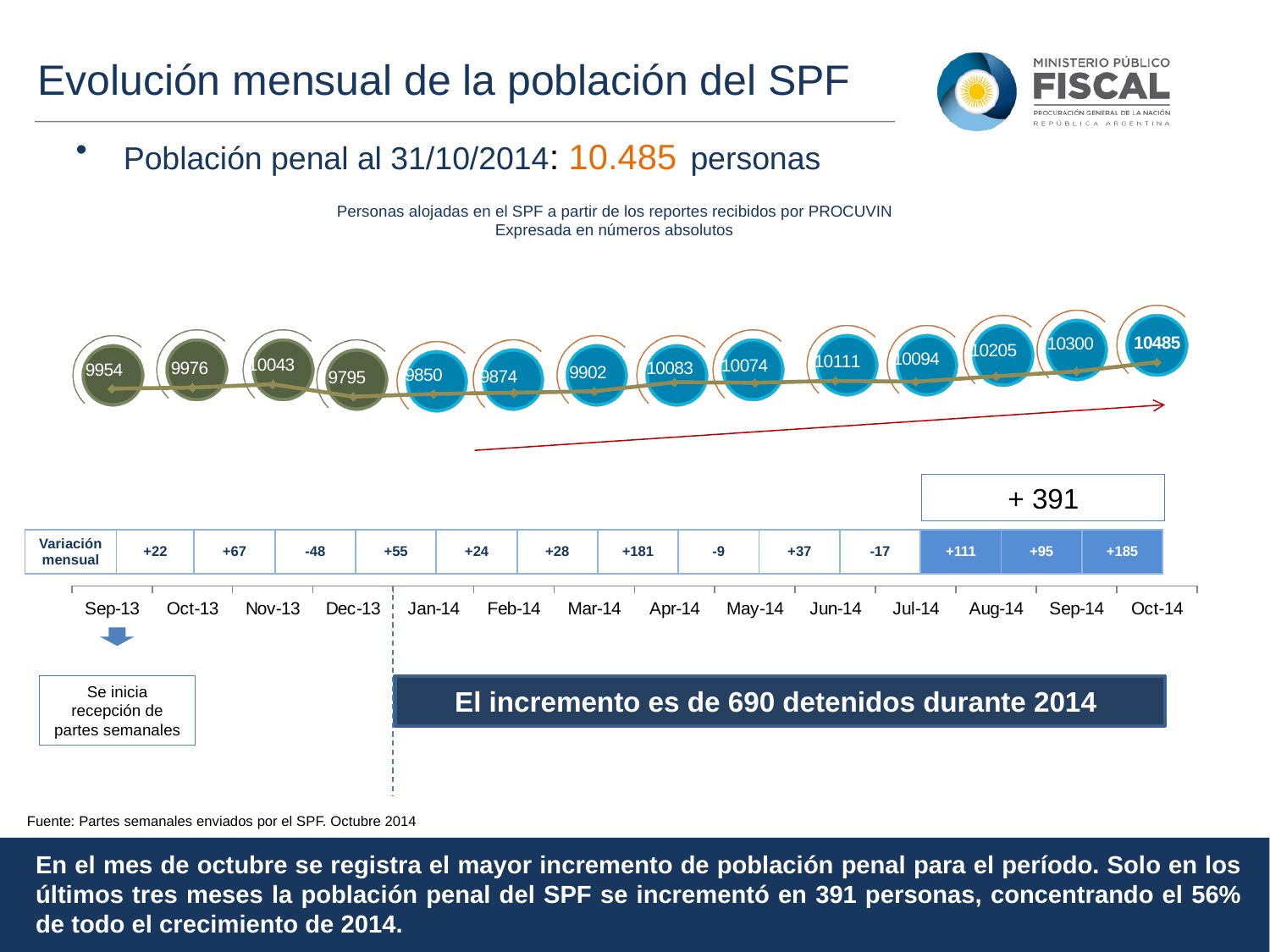
Do the values generally rise or fall from Jan-14 to Oct-14? rise What is the difference between the values for Oct-14 and Sep-14? 185 Which month has the lowest value? Dec-13 What is the value for Oct-14? 10485 What is the value for Apr-14? 10083 What kind of chart is this? line chart What is the difference between the values for Nov-13 and Dec-13? 248 What is the monthly variation (Variación mensual) shown for Mar-14? +28 Which month has the highest value? Oct-14 What is the value for Dec-13? 9795 Which is larger, the value for Nov-13 or the value for Jan-14? Nov-13 How many months are plotted on the chart? 14